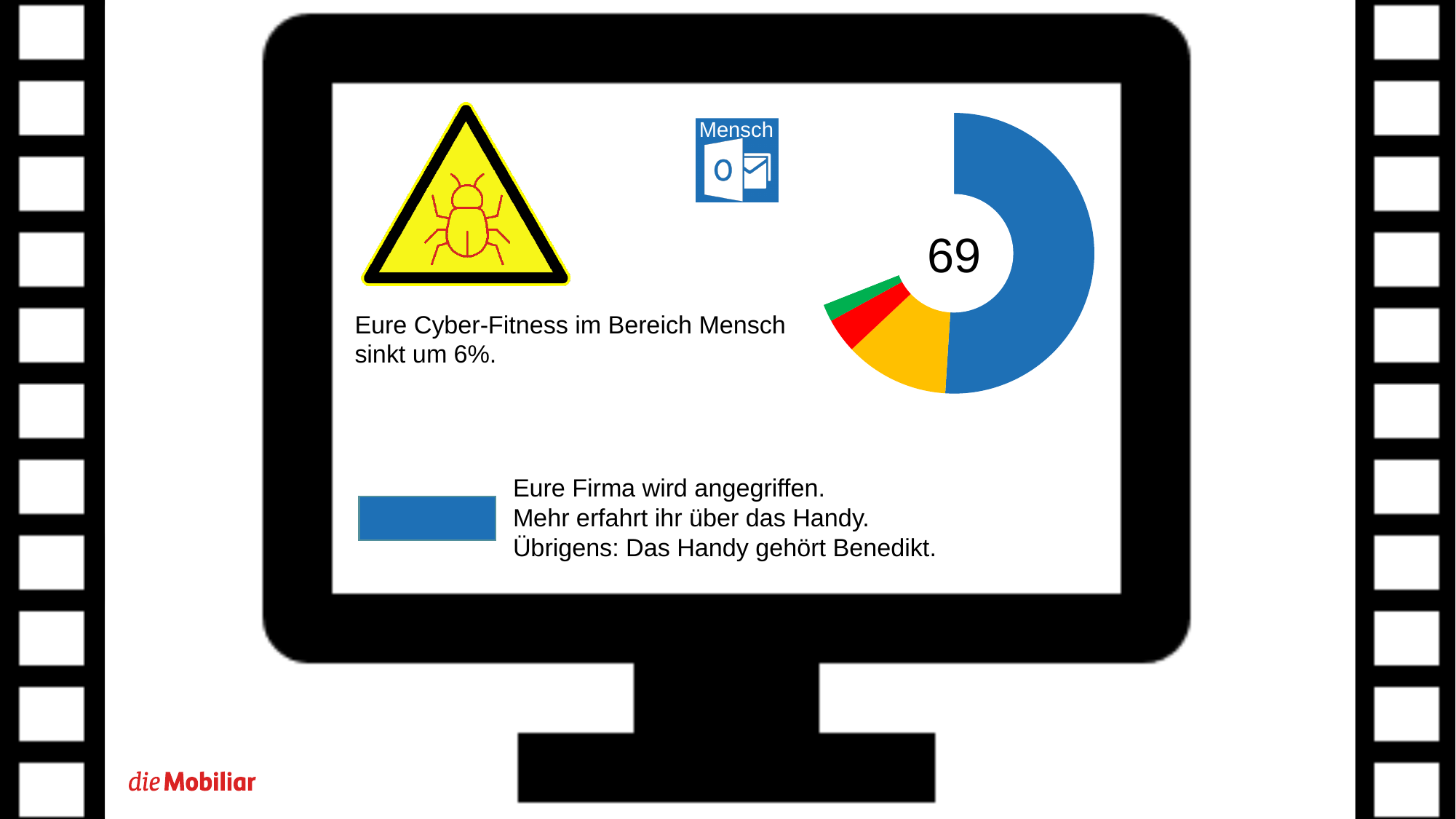
What number is printed in the centre of the doughnut chart? 69 What colour is the segment that sits between the blue and the red segments in the doughnut chart? Yellow Which colour segment of the doughnut chart is the smallest? Green Which colour segment of the doughnut chart is the largest? Blue Does the doughnut chart have a legend? No What kind of chart is shown on the right side of the screen? Doughnut chart In the doughnut chart, which segment is larger, the blue one or the yellow one? Blue How many coloured segments does the doughnut chart have? 4 In the doughnut chart, which segment is larger, the red one or the green one? Red